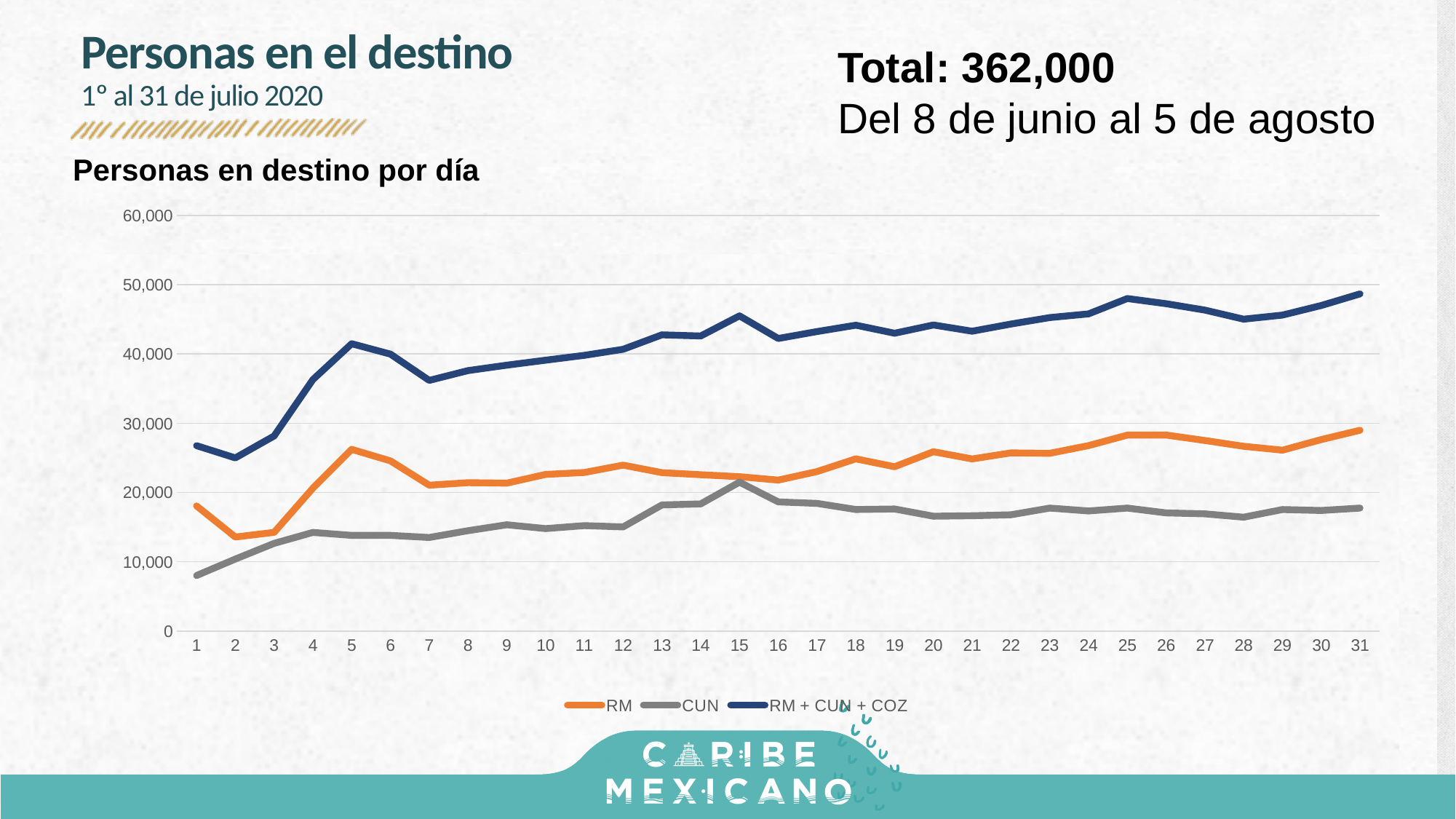
On which day does the CUN series reach its highest value? 15 What kind of chart is shown on the slide? line chart On which day is the RM + CUN + COZ series at its lowest? 2 How many days are plotted along the x axis? 31 What is the title of the chart? Personas en destino por día Is the value for RM + CUN + COZ on day 31 greater or less than 50,000? less Which series is drawn in orange? RM Is the value for CUN on day 1 greater or less than 10,000? less Is the value for RM + CUN + COZ on day 1 greater or less than 20,000? greater On day 1, which is larger, RM or CUN? RM How many series does the legend list? 3 Does the CUN series rise or fall from day 1 to day 5? rise